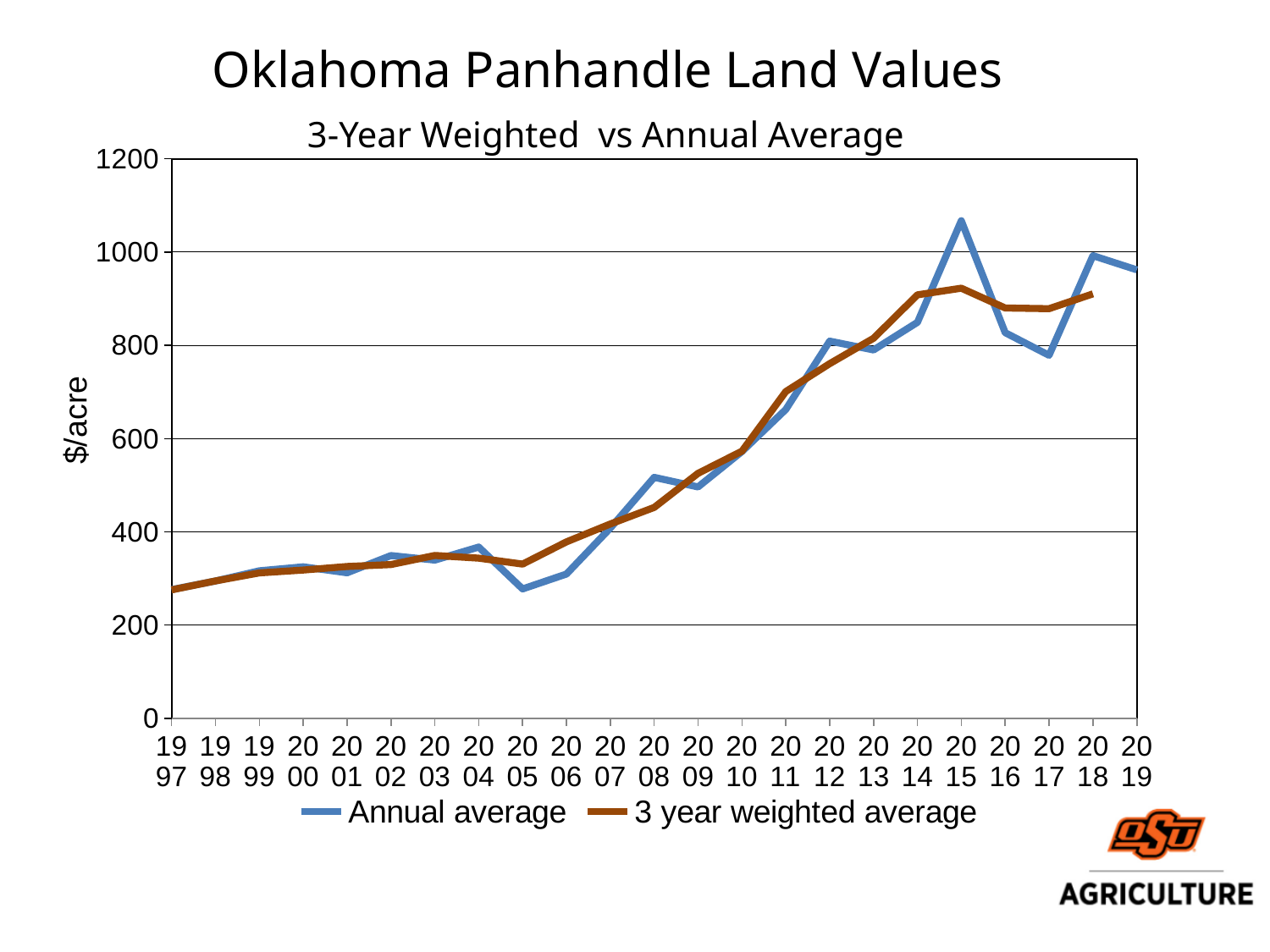
How many series does the legend list? 2 Is the Annual average value for 2015 greater or less than 1000? greater Overall, do land values rise or fall from 1997 to 2019? Rise What is the label on the y axis? $/acre Is the 3 year weighted average value for 2011 greater or less than 600? greater In which year does the Annual average reach its highest value? 2015 How many years are plotted along the x axis? 23 Is the Annual average value for 2005 greater or less than 300? less What kind of chart is shown on the slide? Line chart In 2017, which series has the larger value, Annual average or 3 year weighted average? 3 year weighted average